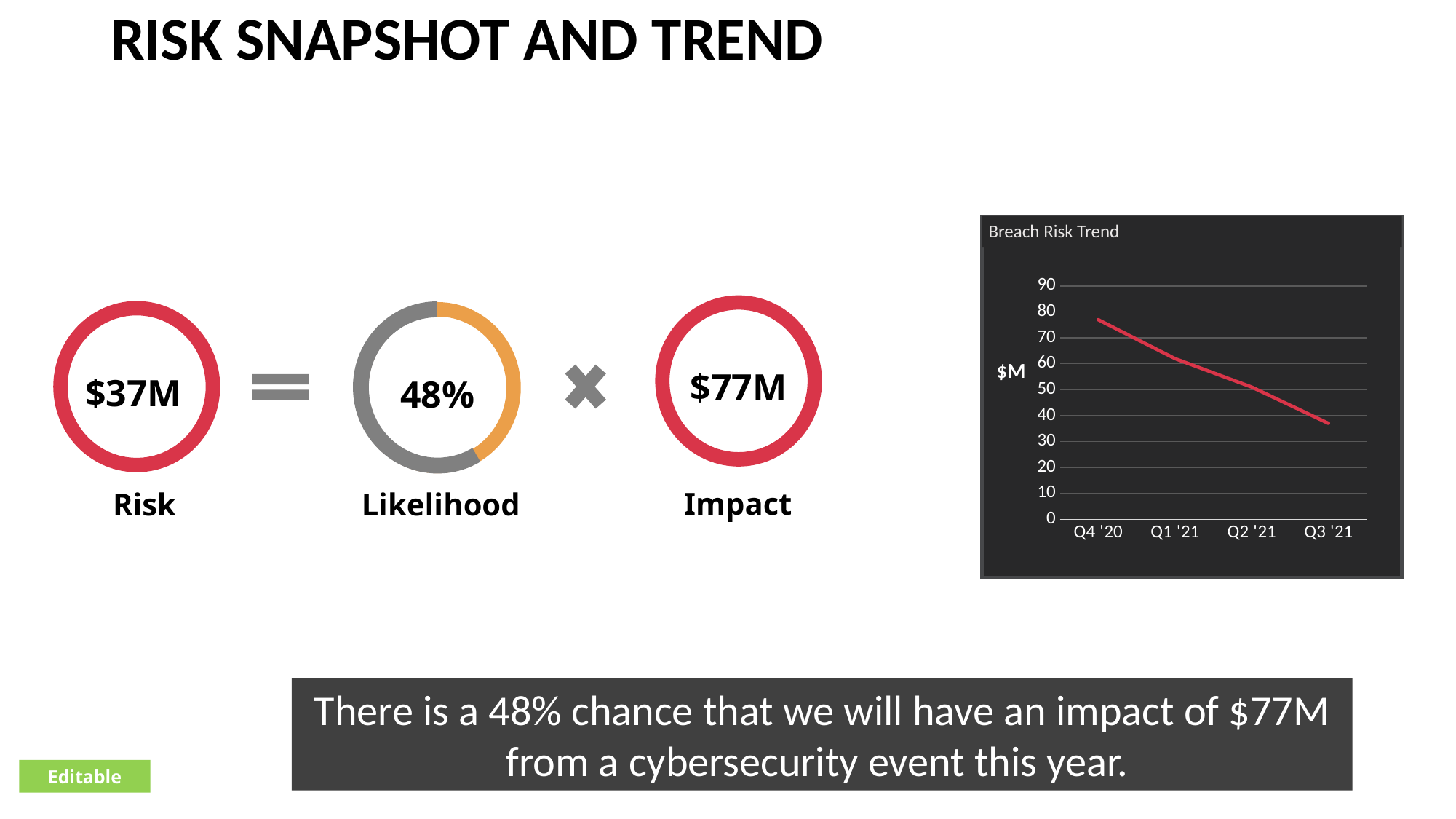
What share does the Likelihood donut chart show? 48% In the Breach Risk Trend chart, which is larger: the value for Q1 '21 or the value for Q3 '21? Q1 '21 What is the title of the line chart on the right of the slide? Breach Risk Trend In the Breach Risk Trend chart, is the value for Q3 '21 greater or less than 50? less What kind of chart is the Breach Risk Trend chart? line chart How many quarters are plotted on the x axis of the Breach Risk Trend chart? 4 In the Breach Risk Trend chart, which quarter has the lowest value? Q3 '21 In the Breach Risk Trend chart, which quarter has the highest value? Q4 '20 In the Breach Risk Trend chart, is the value for Q1 '21 greater or less than 50? greater What unit label is shown on the y axis of the Breach Risk Trend chart? $M In the Breach Risk Trend chart, do the values rise or fall from Q4 '20 to Q3 '21? fall In the Breach Risk Trend chart, is the value for Q4 '20 greater or less than 70? greater